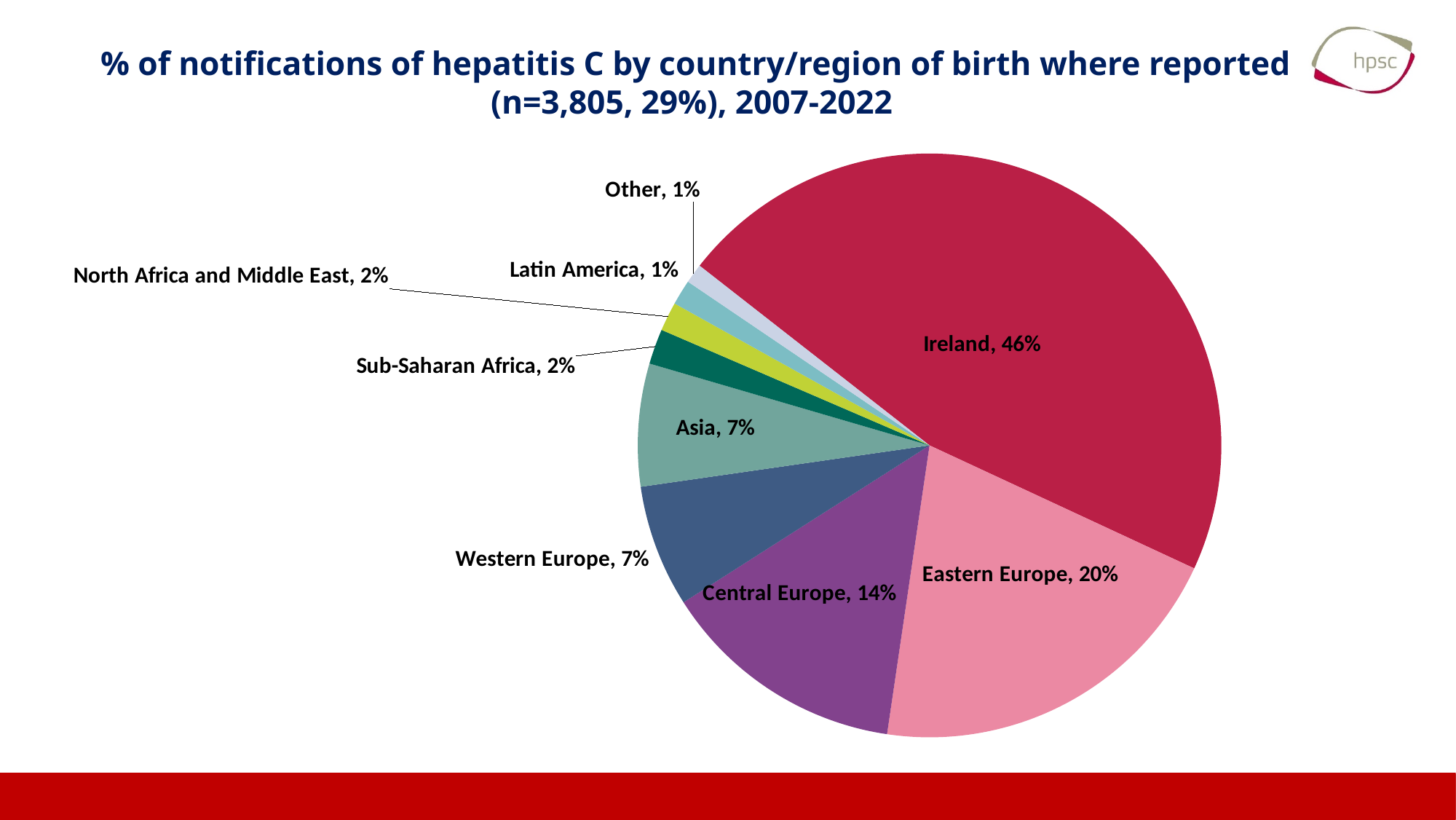
What percentage of notifications were for people born in Eastern Europe? 20% What is the combined share of Eastern Europe and Central Europe? 34% How many country/region categories are shown in the pie chart? 9 What percentage of hepatitis C notifications were for people born in Ireland? 46% Which country/region of birth has the largest share of notifications? Ireland Which has a larger share, Central Europe or Western Europe? Central Europe What is the total number of notifications (n) stated in the chart title? 3,805 What percentage of notifications were for people born in Central Europe? 14% What percentage of notifications were for people born in Sub-Saharan Africa? 2% What kind of chart is shown on the slide? Pie chart What is the difference in percentage points between Ireland and Eastern Europe? 26 What percentage of notifications were for people born in Asia? 7%